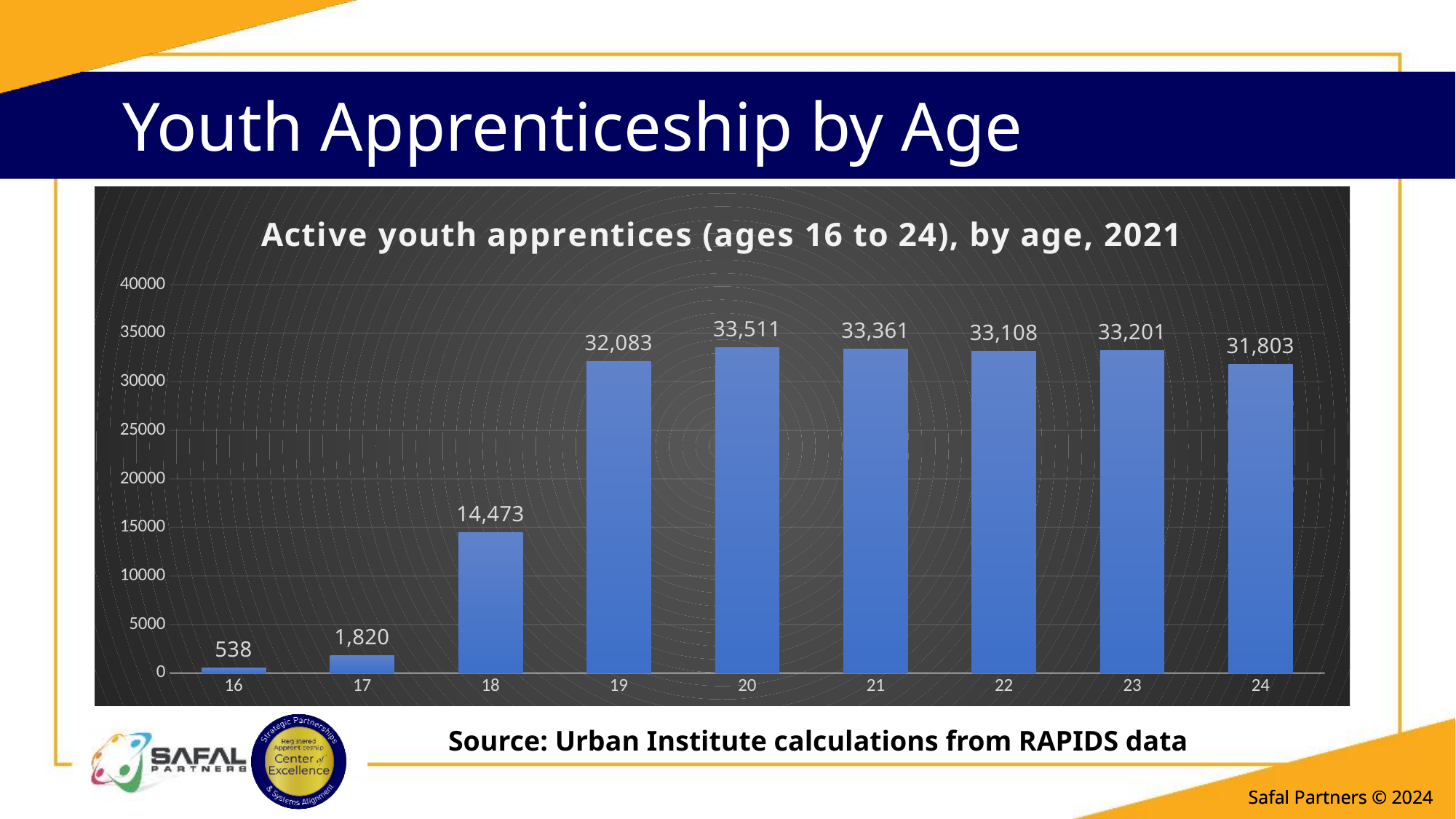
What is the difference between the number of apprentices aged 20 and aged 19? 1,428 What is the number of active youth apprentices aged 16? 538 What is the difference between the number of apprentices aged 18 and aged 17? 12,653 Which age has the highest number of active youth apprentices? 20 Is the value for age 18 greater or less than 15000? less Which age has the lowest number of active youth apprentices? 16 What is the number of active youth apprentices aged 18? 14,473 Which age has more active apprentices, 21 or 22? 21 What is the title of the chart? Active youth apprentices (ages 16 to 24), by age, 2021 What is the number of active youth apprentices aged 24? 31,803 How many age categories are shown on the x axis? 9 What kind of chart is shown on the slide? Bar chart